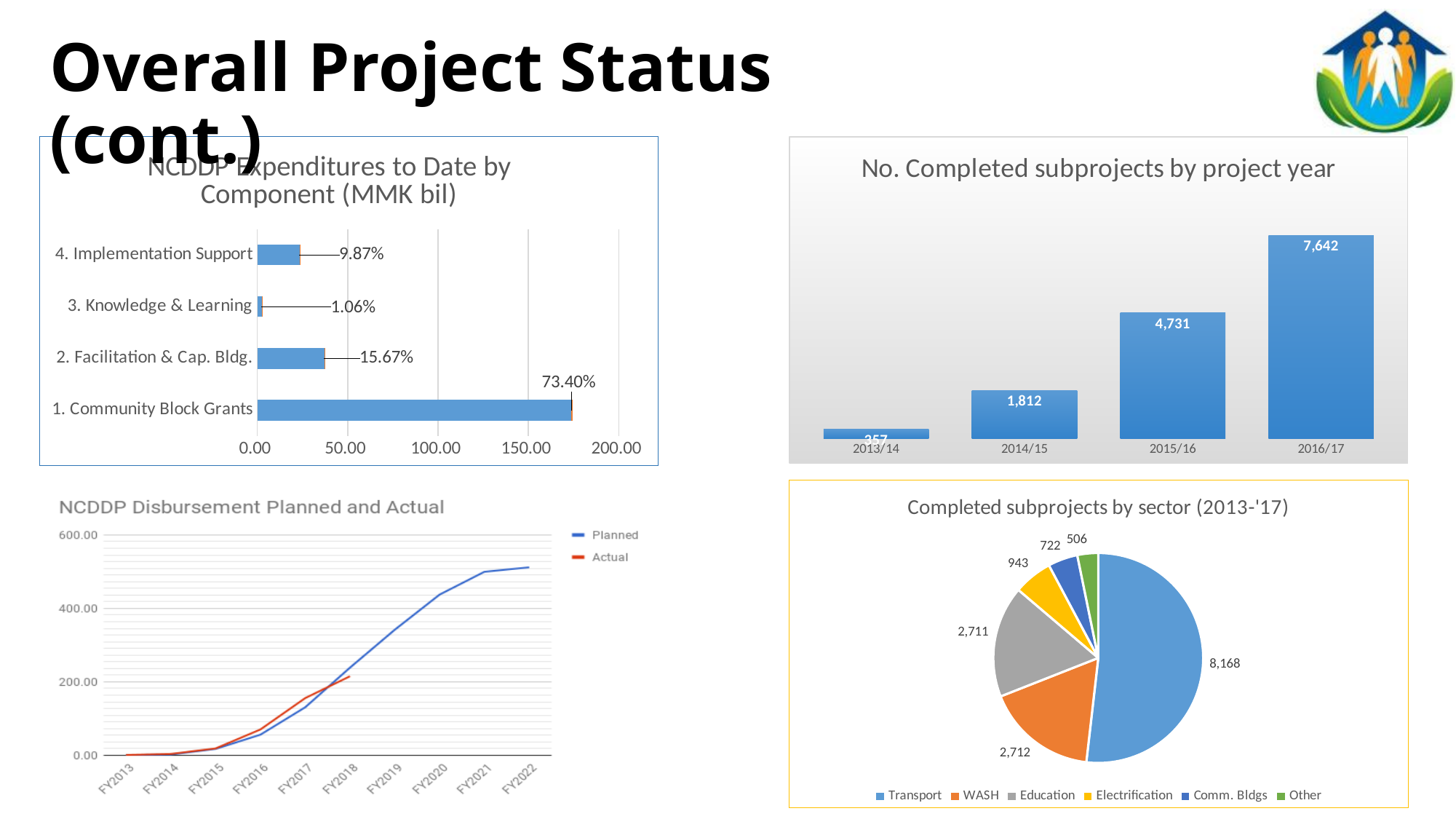
In the 'No. Completed subprojects by project year' chart, how many subprojects were completed in 2015/16? 4,731 In the 'NCDDP Expenditures to Date by Component (MMK bil)' chart, which component has the lowest share? 3. Knowledge & Learning In the 'NCDDP Expenditures to Date by Component (MMK bil)' chart, what percentage is shown for 1. Community Block Grants? 73.40% In the 'NCDDP Expenditures to Date by Component (MMK bil)' chart, how many components are listed? 4 What kind of chart is 'NCDDP Disbursement Planned and Actual'? line chart In the 'Completed subprojects by sector (2013-'17)' pie chart, which sector is larger, Electrification or Comm. Bldgs? Electrification In the 'No. Completed subprojects by project year' chart, which project year has the highest number of completed subprojects? 2016/17 In the 'No. Completed subprojects by project year' chart, do the values rise or fall from 2013/14 to 2016/17? rise In the 'Completed subprojects by sector (2013-'17)' pie chart, what is the value for WASH? 2,712 How many series does the legend of the 'NCDDP Disbursement Planned and Actual' chart list? 2 In the 'NCDDP Expenditures to Date by Component (MMK bil)' chart, is the value for 1. Community Block Grants greater or less than 150.00? greater In the 'No. Completed subprojects by project year' chart, what is the difference between the 2016/17 and 2015/16 values? 2,911